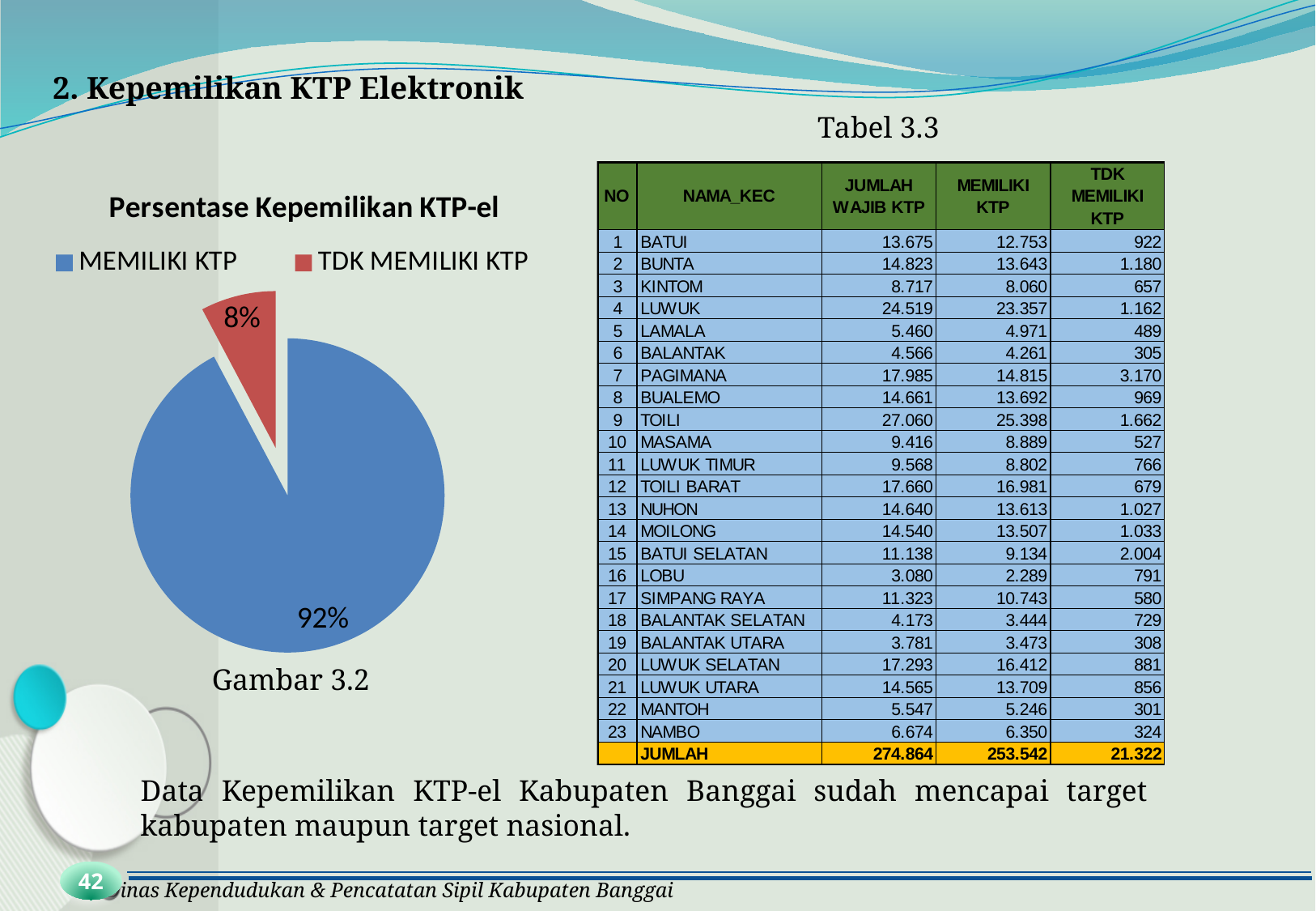
How many entries does the pie chart's legend list? 2 What kind of chart is shown on the slide? pie chart Which is larger in the pie chart, MEMILIKI KTP or TDK MEMILIKI KTP? MEMILIKI KTP Which slice of the pie chart is the largest? MEMILIKI KTP What is the value label shown on the blue slice of the pie chart? 92% Which slice of the pie chart is the smallest? TDK MEMILIKI KTP How many slices does the pie chart have? 2 What is the title of the pie chart? Persentase Kepemilikan KTP-el What share of the pie does TDK MEMILIKI KTP represent? 8% What share of the pie does MEMILIKI KTP represent? 92% What colour is the TDK MEMILIKI KTP slice in the pie chart? red What is the difference in percentage points between the MEMILIKI KTP slice and the TDK MEMILIKI KTP slice? 84 percentage points